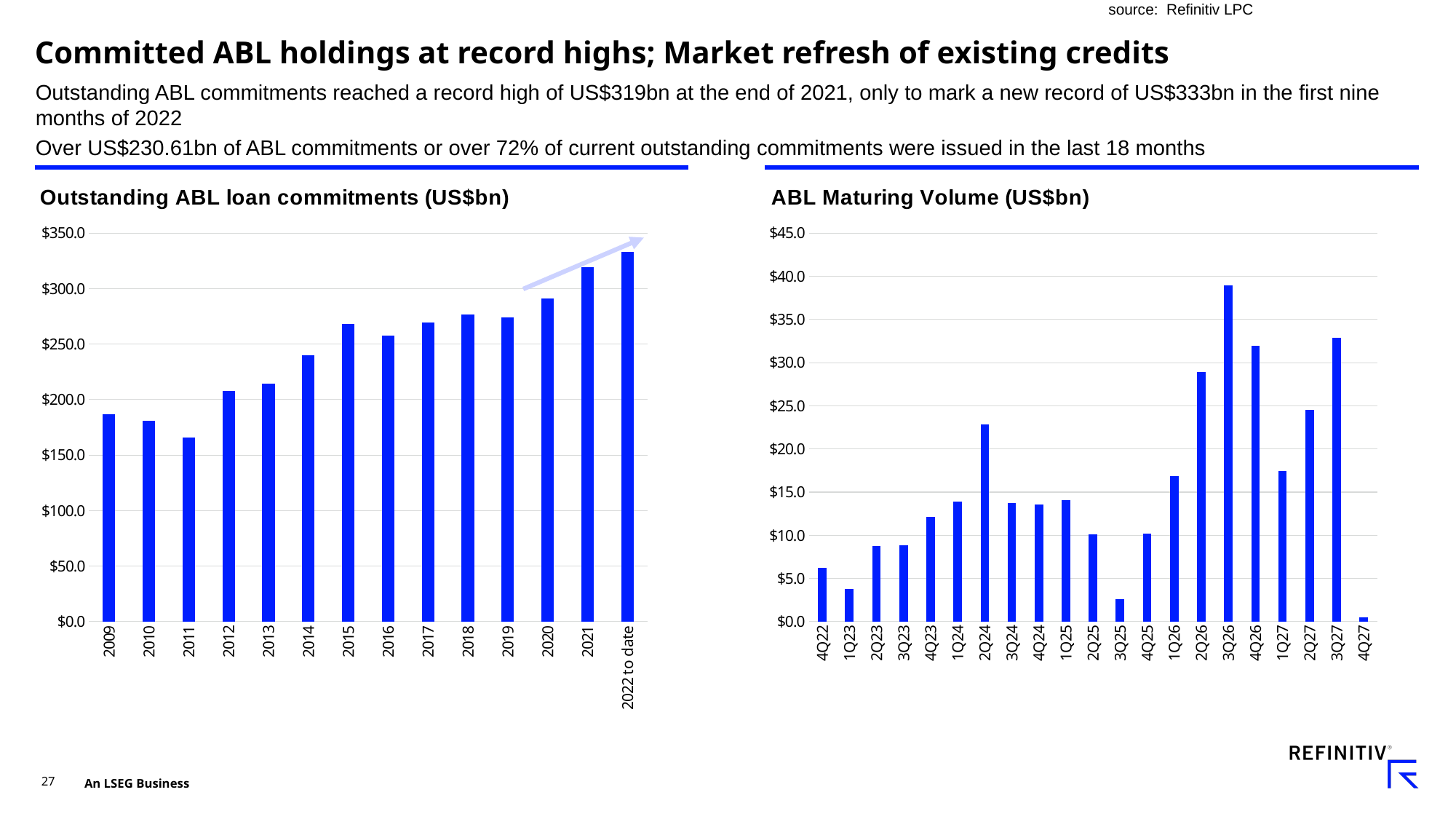
In the 'ABL Maturing Volume (US$bn)' chart, which quarter has the lowest value? 4Q27 In the 'ABL Maturing Volume (US$bn)' chart, which quarter has the highest value? 3Q26 How many categories are shown on the x axis of the 'ABL Maturing Volume (US$bn)' chart? 21 In the 'Outstanding ABL loan commitments (US$bn)' chart, is the value for 2014 greater or less than $250.0? less What kind of chart is the 'Outstanding ABL loan commitments (US$bn)' chart on the left? Bar chart In the 'Outstanding ABL loan commitments (US$bn)' chart, which year has the lowest value? 2011 How many categories are shown on the x axis of the 'Outstanding ABL loan commitments (US$bn)' chart? 14 In the 'Outstanding ABL loan commitments (US$bn)' chart, is the value for 2021 greater or less than $300.0? greater In the 'Outstanding ABL loan commitments (US$bn)' chart, do the values generally rise or fall from 2009 to 2022 to date? Rise In the 'ABL Maturing Volume (US$bn)' chart, which is larger, the value for 1Q23 or the value for 2Q23? 2Q23 In the 'ABL Maturing Volume (US$bn)' chart, is the value for 2Q24 greater or less than $20.0? greater In the 'Outstanding ABL loan commitments (US$bn)' chart, which category has the highest value? 2022 to date